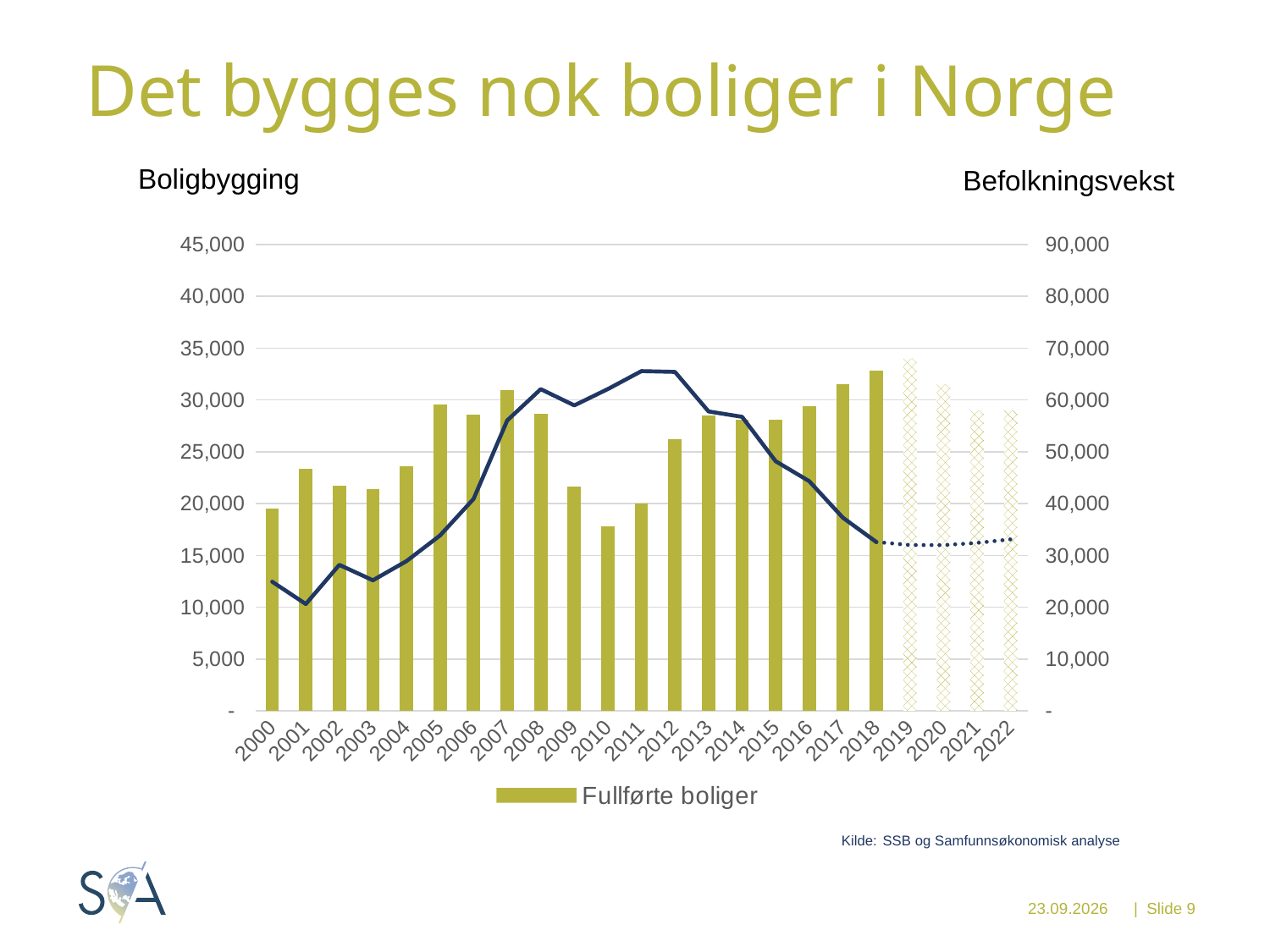
Which year has the highest bar for Fullførte boliger? 2019 Is the Fullførte boliger bar for 2018 greater or less than 30,000? greater How many series does the chart's legend list? 1 How many years are shown along the x axis of the chart? 23 Which year has the lowest bar for Fullførte boliger? 2010 Does the Befolkningsvekst line rise or fall between 2012 and 2018? It falls In which year is the Befolkningsvekst line at its lowest point? 2001 Is the Fullførte boliger bar for 2010 greater or less than 20,000? less Is the Befolkningsvekst line value for 2008 greater or less than 60,000 on the right axis? greater Which year has a taller Fullførte boliger bar, 2007 or 2009? 2007 What kind of chart is shown on the slide? A combined bar and line chart What is the label of the series listed in the chart's legend? Fullførte boliger